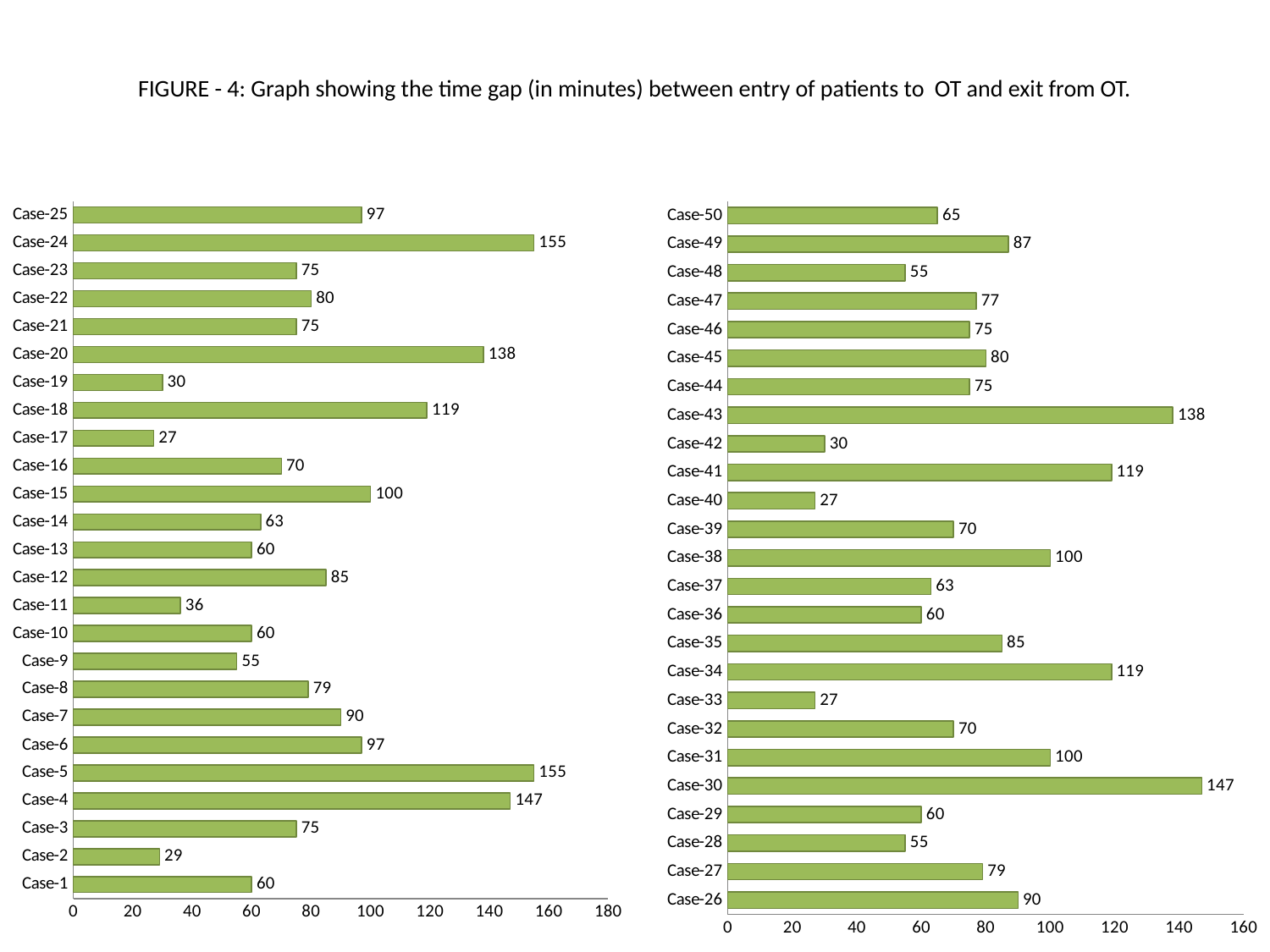
On the right chart, what is the value for Case-28? 55 On the left chart, which is larger, the value for Case-12 or the value for Case-14? Case-12 On the right chart, what is the difference between the values for Case-30 and Case-40? 120 On the left chart, what is the value for Case-18? 119 How many cases are shown on the left chart? 25 On the right chart, which is larger, the value for Case-49 or the value for Case-48? Case-49 On the left chart, what is the value for Case-24? 155 On the right chart, what is the value for Case-43? 138 What is the figure number given in the slide title? FIGURE - 4 On the left chart, what is the difference between the values for Case-20 and Case-19? 108 What kind of chart is shown on the right side of the slide? Bar chart On the right chart, which case has the highest value? Case-30